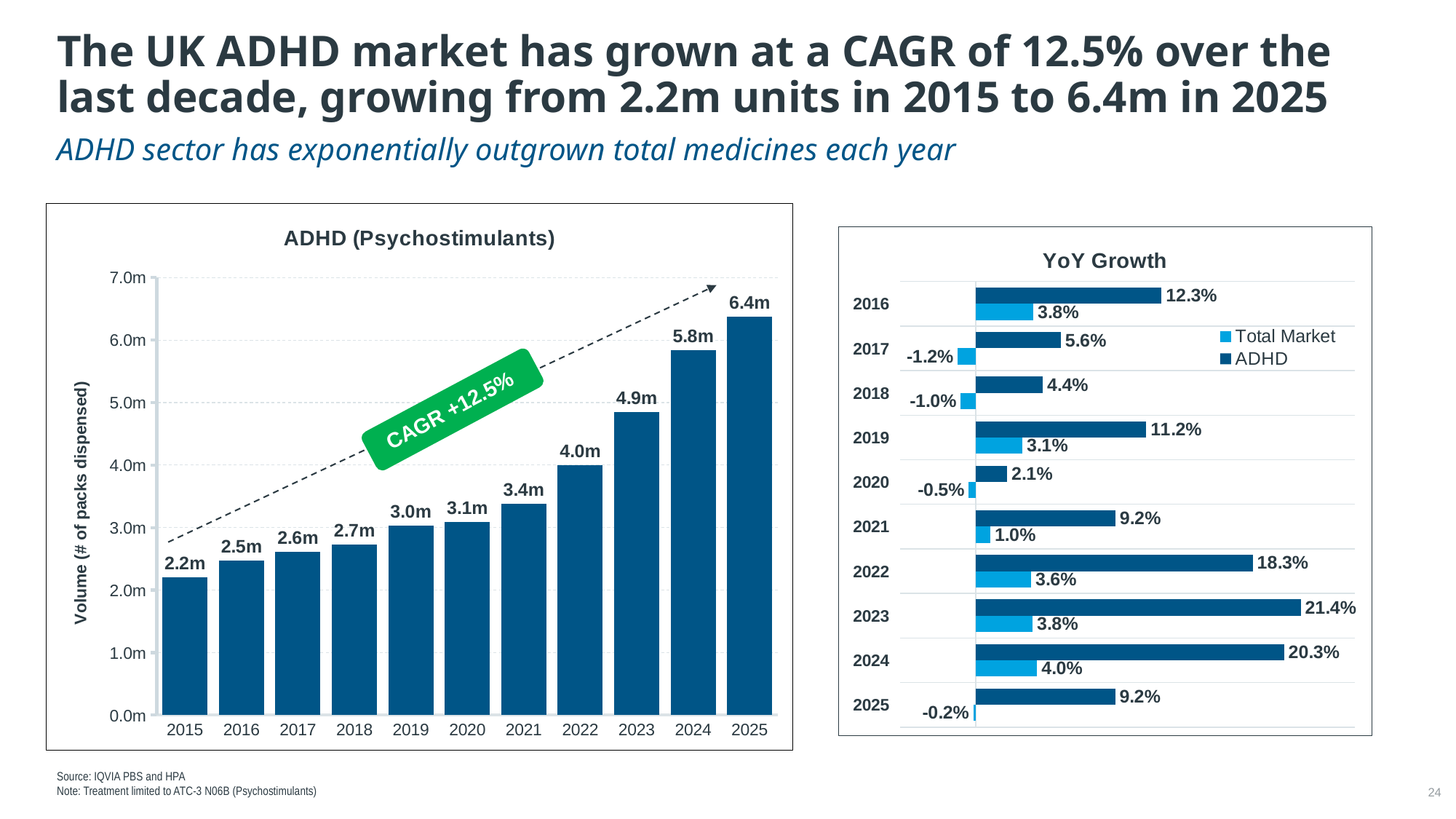
In the ADHD (Psychostimulants) chart, how many years are shown on the x axis? 11 In the YoY Growth chart, what is the Total Market growth for 2017? -1.2% In the ADHD (Psychostimulants) chart, do the volumes rise or fall from 2015 to 2025? rise In the YoY Growth chart, which is larger for 2022: ADHD growth or Total Market growth? ADHD In the ADHD (Psychostimulants) chart, what is the difference between the 2025 and 2024 volumes? 0.6m What kind of chart is the YoY Growth chart? bar chart In the YoY Growth chart, which year has the highest ADHD growth? 2023 In the ADHD (Psychostimulants) chart, which year has the highest volume? 2025 In the YoY Growth chart, what is the ADHD growth for 2023? 21.4% In the ADHD (Psychostimulants) chart, which year has the lowest volume? 2015 In the YoY Growth chart, how many series does the legend list? 2 In the ADHD (Psychostimulants) chart, what is the volume for 2019? 3.0m